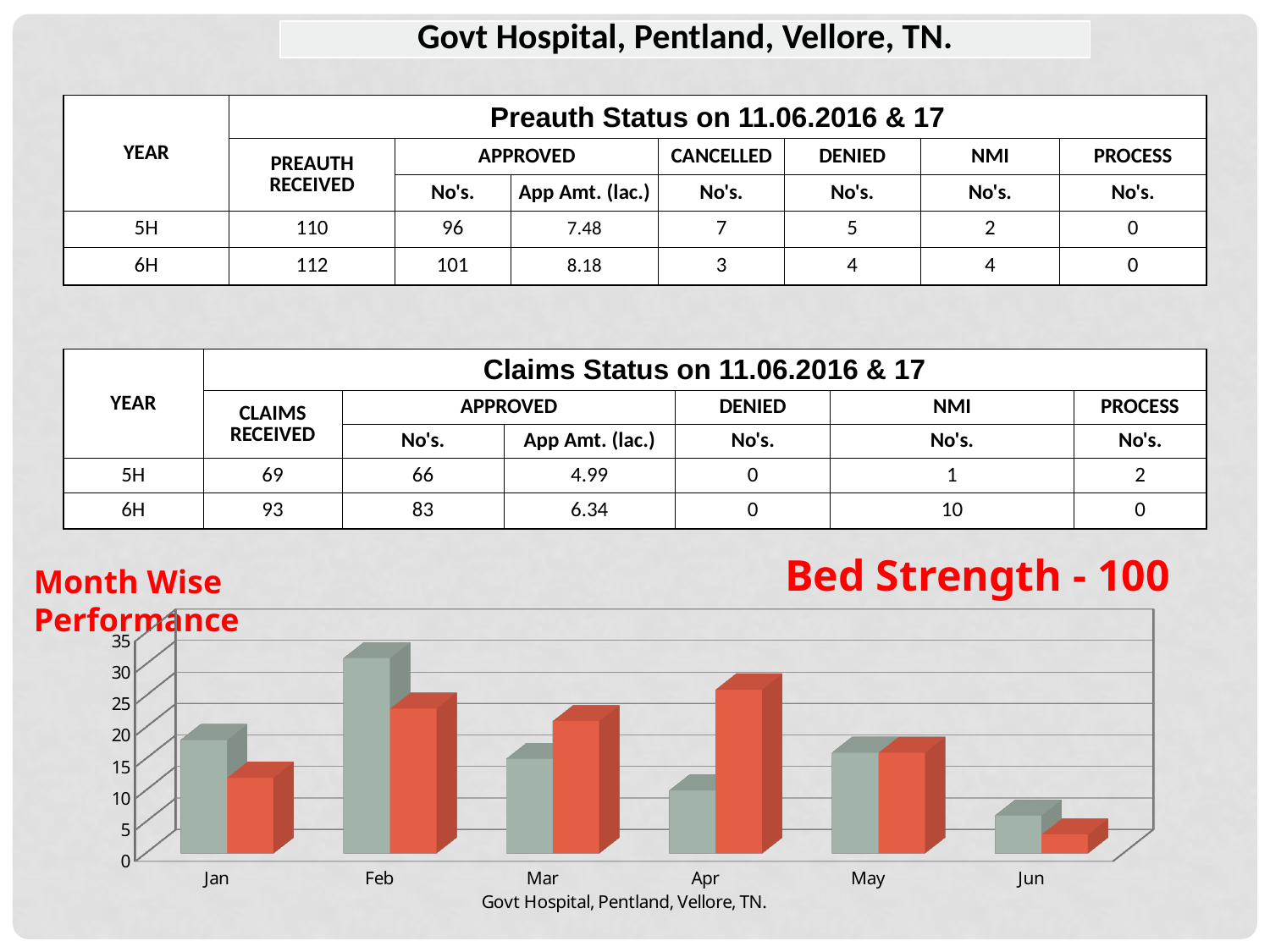
Which month has the tallest grey bar in the chart? Feb In Apr, is the grey bar or the red bar taller? red Which month has the shortest grey bar in the chart? Jun How many months are shown on the x axis of the chart? 6 Which month has the shortest red bar in the chart? Jun Is the value of the grey bar for Feb greater or less than 25? greater Is the value of the grey bar for Jun greater or less than 10? less What text appears below the x axis of the chart? Govt Hospital, Pentland, Vellore, TN. In Jan, is the grey bar or the red bar taller? grey Is the value of the red bar for Jan greater or less than 15? less What kind of chart is shown at the bottom of the slide? bar chart Which month has the tallest red bar in the chart? Apr